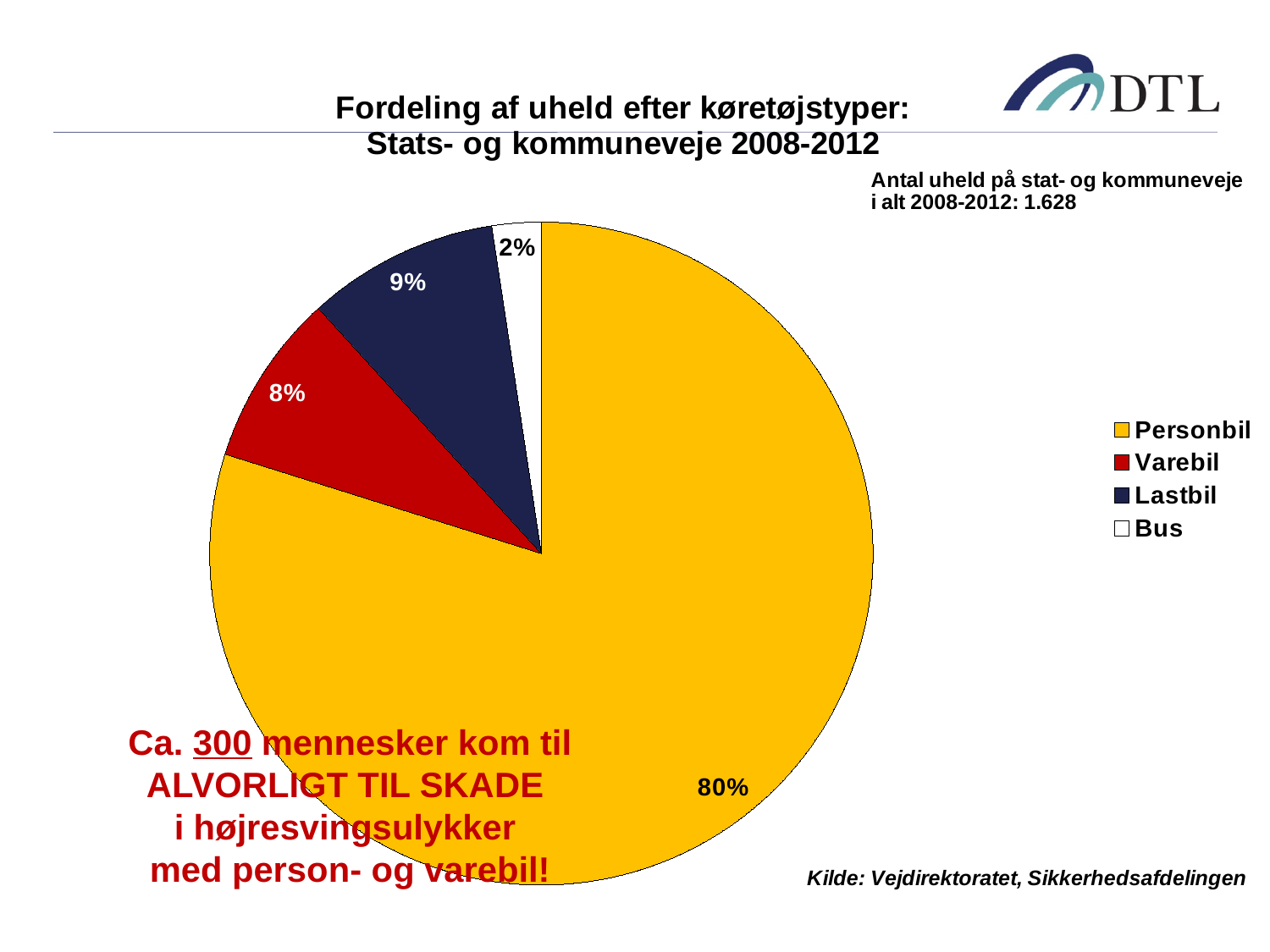
What share of the pie does Bus account for? 2% Which colour represents Varebil in the pie chart? Red What share of the pie does Varebil account for? 8% Which slice is larger, Varebil or Bus? Varebil Which category has the largest slice of the pie? Personbil What share of the pie does Personbil account for? 80% What kind of chart is shown on the slide? Pie chart What is the difference in percentage points between the Lastbil and Varebil slices? 1 How many categories does the pie chart show? 4 What is the difference in percentage points between the Personbil and Lastbil slices? 71 Which category has the smallest slice of the pie? Bus